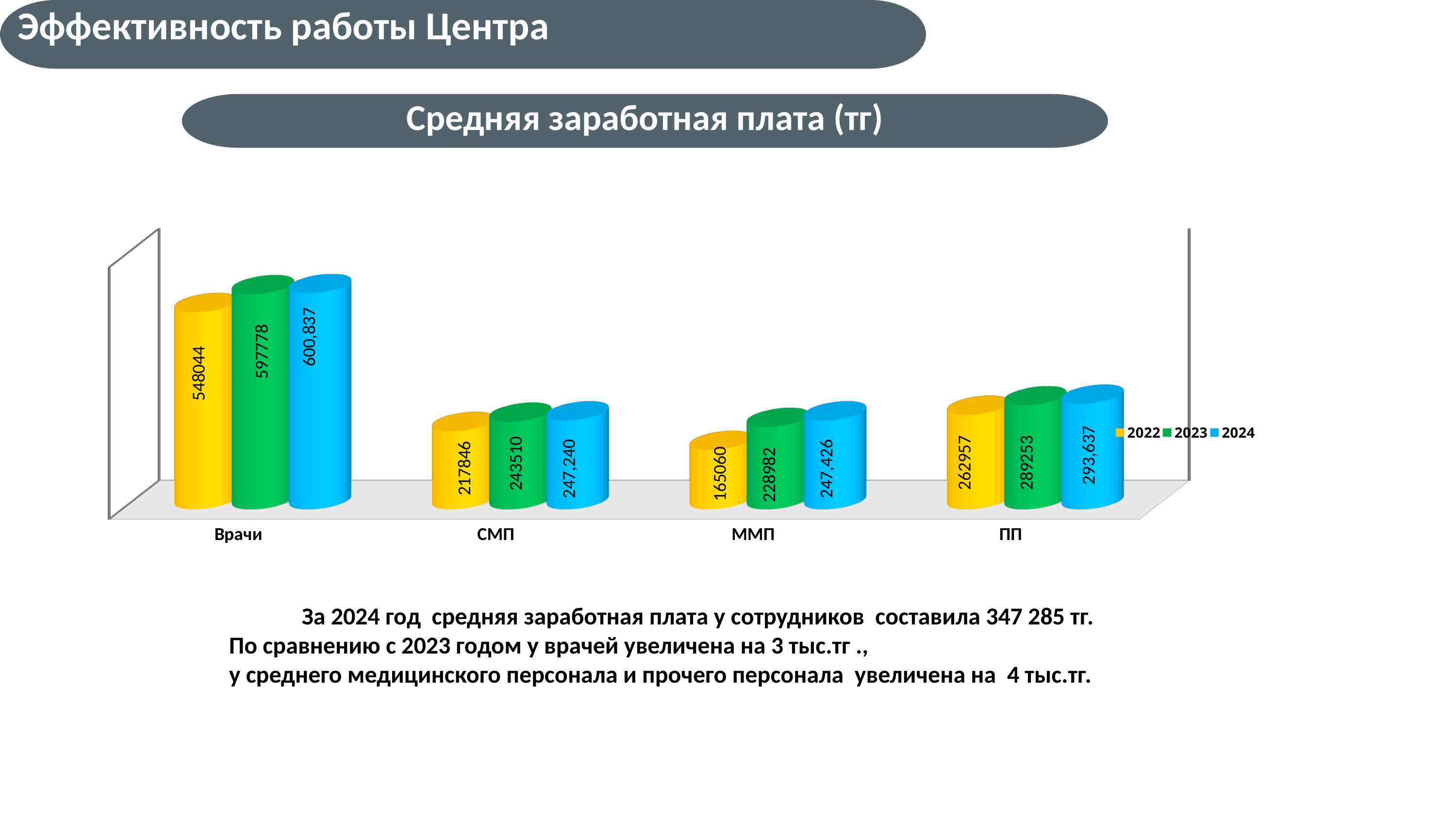
What is the average salary for ПП in 2023? 289253 What is the average salary for СМП in 2024? 247,240 What is the title of the chart? Средняя заработная плата (тг) Which category has the lowest average salary in 2022? ММП What is the average salary for ММП in 2024? 247,426 How many series does the legend list? 3 What is the average salary for Врачи in 2022? 548044 What kind of chart is shown on the slide? Bar chart Which is larger: the 2022 average salary for ПП or the 2022 average salary for СМП? ПП Which category has the highest average salary in 2024? Врачи How many staff categories are shown on the x axis? 4 What is the difference between the 2023 and 2022 average salary for ММП? 63922